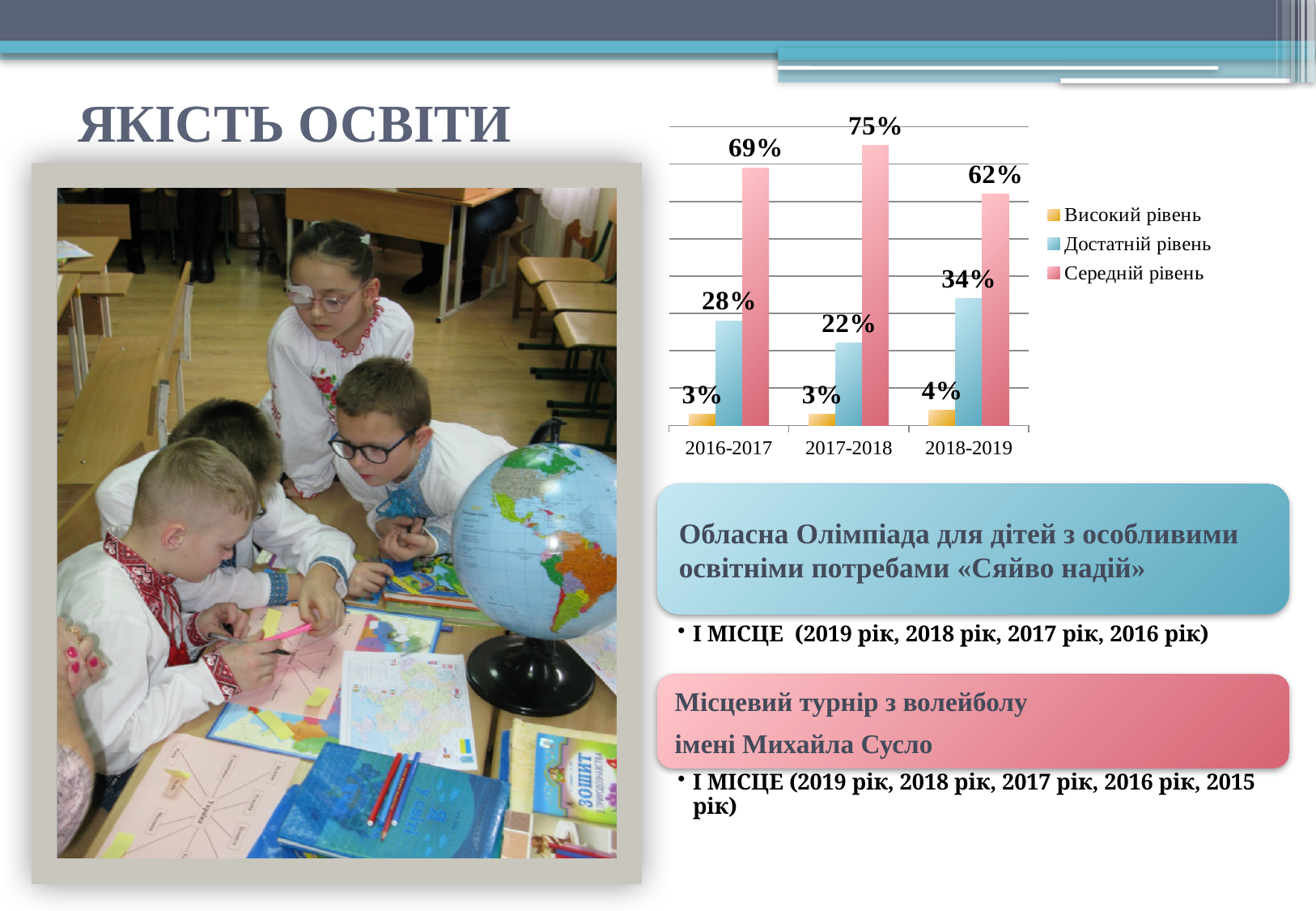
Which series is shown in pink in the legend? Середній рівень What is the difference between Середній рівень in 2017-2018 and in 2018-2019? 13% In which year is Достатній рівень lowest? 2017-2018 How many year categories are shown on the x axis? 3 What is the value of Середній рівень for 2017-2018? 75% Which is larger: Достатній рівень in 2016-2017 or in 2018-2019? 2018-2019 How many series does the legend list? 3 What kind of chart is shown on the slide? bar chart Does Достатній рівень rise or fall from 2017-2018 to 2018-2019? rise In which year is Середній рівень highest? 2017-2018 What is the value of Достатній рівень for 2018-2019? 34% What is the value of Високий рівень for 2016-2017? 3%